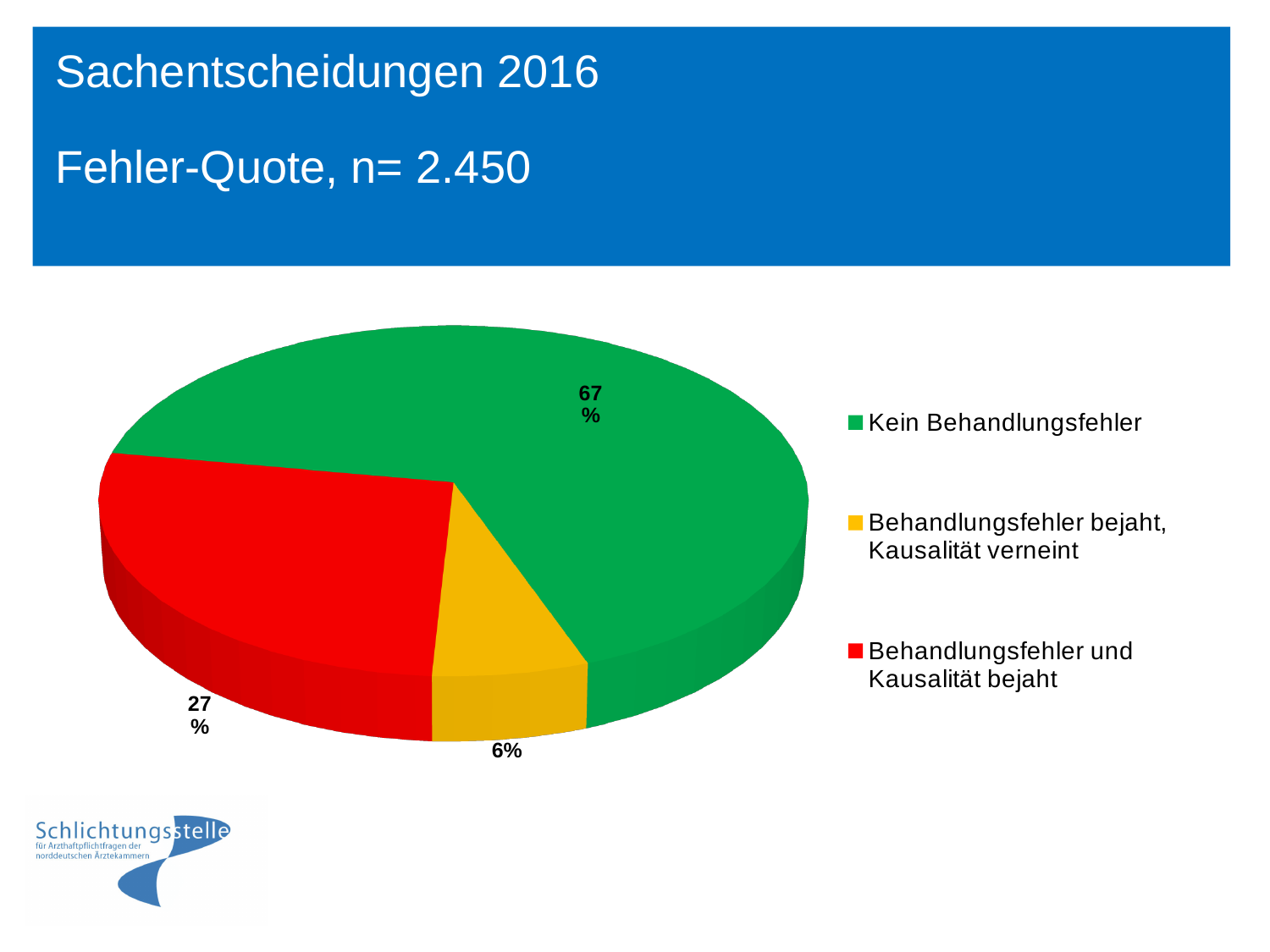
What colour is the slice for "Kein Behandlungsfehler"? green What kind of chart is shown on the slide? pie chart What share of the pie does "Behandlungsfehler bejaht, Kausalität verneint" represent? 6% How many categories does the pie chart show? 3 What is the value of n given in the slide title? 2.450 How many entries does the legend list? 3 Which is larger: the share for "Behandlungsfehler und Kausalität bejaht" or the share for "Behandlungsfehler bejaht, Kausalität verneint"? Behandlungsfehler und Kausalität bejaht What share of the pie does "Kein Behandlungsfehler" represent? 67% Which category has the largest slice of the pie? Kein Behandlungsfehler What share of the pie does "Behandlungsfehler und Kausalität bejaht" represent? 27% What is the difference in percentage points between "Kein Behandlungsfehler" and "Behandlungsfehler und Kausalität bejaht"? 40 percentage points Which category has the smallest slice of the pie? Behandlungsfehler bejaht, Kausalität verneint